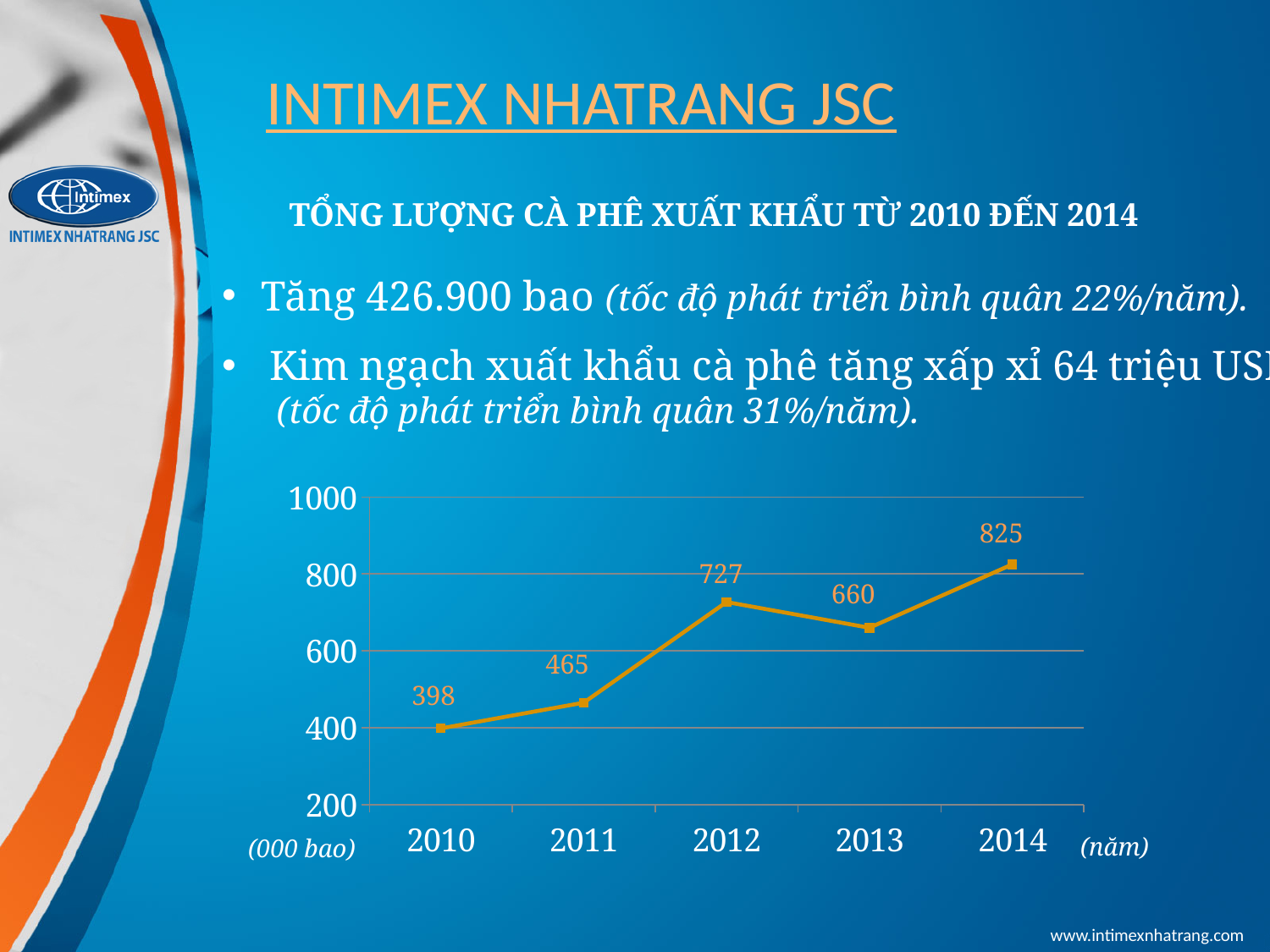
What is the difference between the values for 2014 and 2010? 427 Which year has the highest value? 2014 How many years are plotted on the chart? 5 What is the value for 2013? 660 What is the value for 2010? 398 What kind of chart is shown on the slide? line chart What unit is shown on the vertical axis of the chart? (000 bao) What is the difference between the values for 2012 and 2013? 67 Which year has the lowest value? 2010 What is the value for 2012? 727 Which is larger, the value for 2011 or the value for 2013? 2013 Is the value for 2014 greater or less than 800? greater